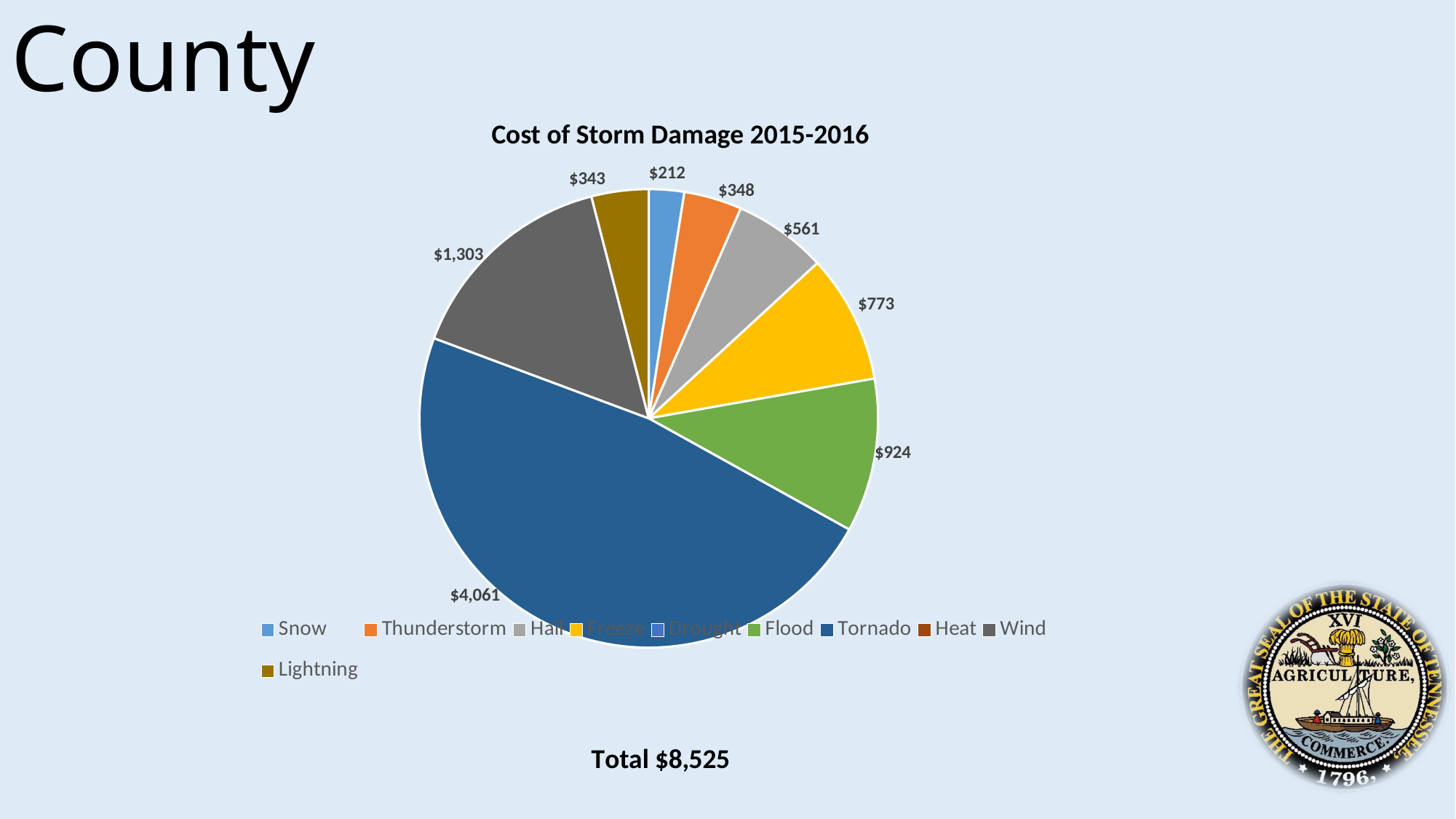
What is the title of the chart? Cost of Storm Damage 2015-2016 Which is larger, the cost for Hail or the cost for Lightning? Hail What is the cost of storm damage attributed to Flood? $924 What is the cost of storm damage attributed to Tornado? $4,061 How many categories are listed in the chart's legend? 10 What type of chart is shown on the slide? Pie chart What is the cost of storm damage attributed to Wind? $1,303 What is the difference between the Wind cost and the Flood cost? $379 What share of the total cost does the Tornado slice represent? 47.6% What is the total cost of storm damage shown on the slide? $8,525 What is the cost of storm damage attributed to Snow? $212 Which storm type has the largest slice of the pie? Tornado